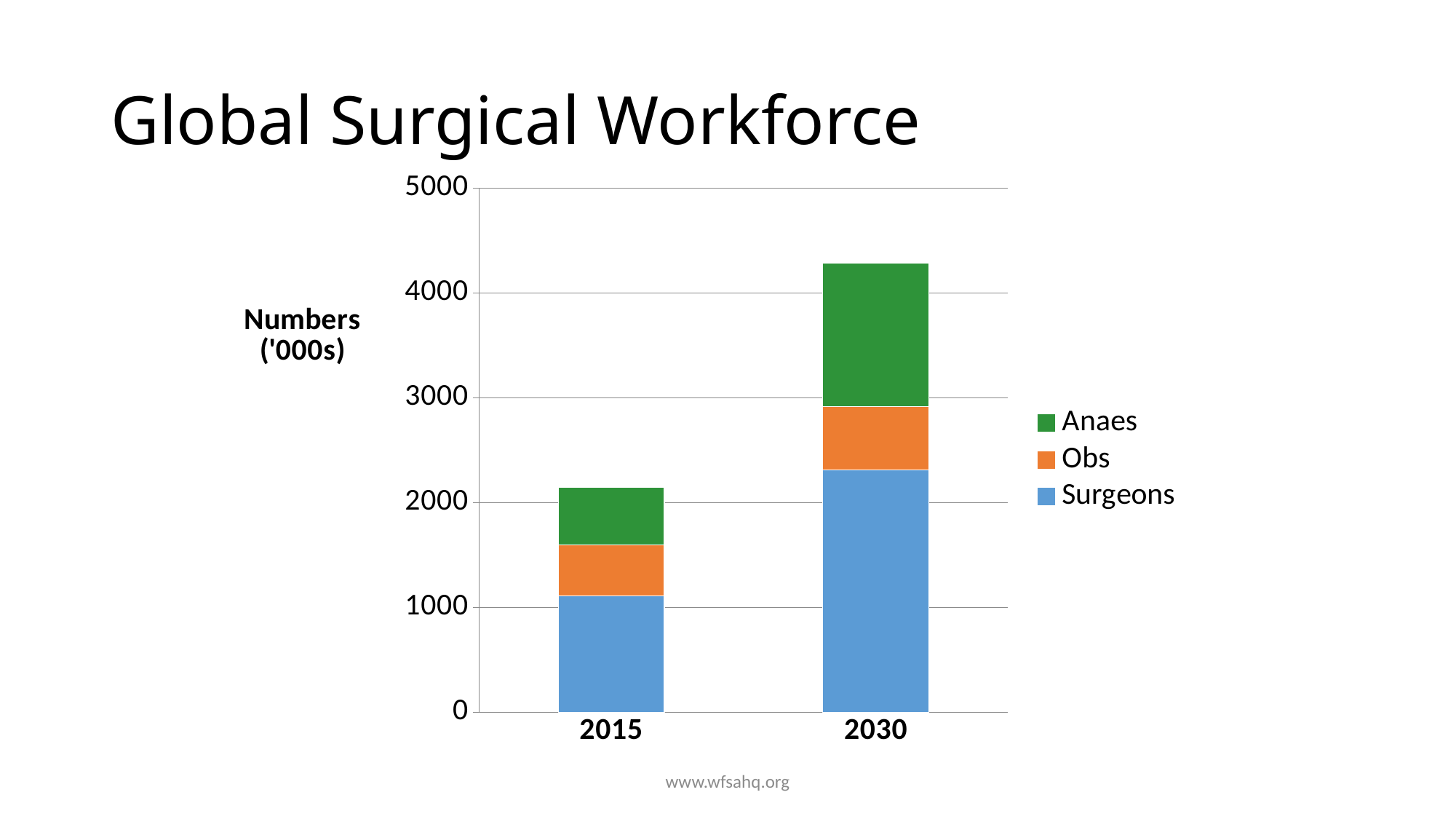
Is the Anaes segment larger in 2015 or in 2030? 2030 How many years (categories) are shown on the x axis? 2 Is the total stacked value for 2015 greater or less than 3000? less How many series does the legend list? 3 Is the Surgeons value for 2015 greater or less than 2000? less In 2030, which segment is larger, Surgeons or Anaes? Surgeons What is the label on the vertical axis? Numbers ('000s) Which year has the taller total bar, 2015 or 2030? 2030 Is the total stacked value for 2030 greater or less than 4000? greater What kind of chart is shown on the slide? Stacked bar chart Does the total workforce rise or fall from 2015 to 2030? Rise